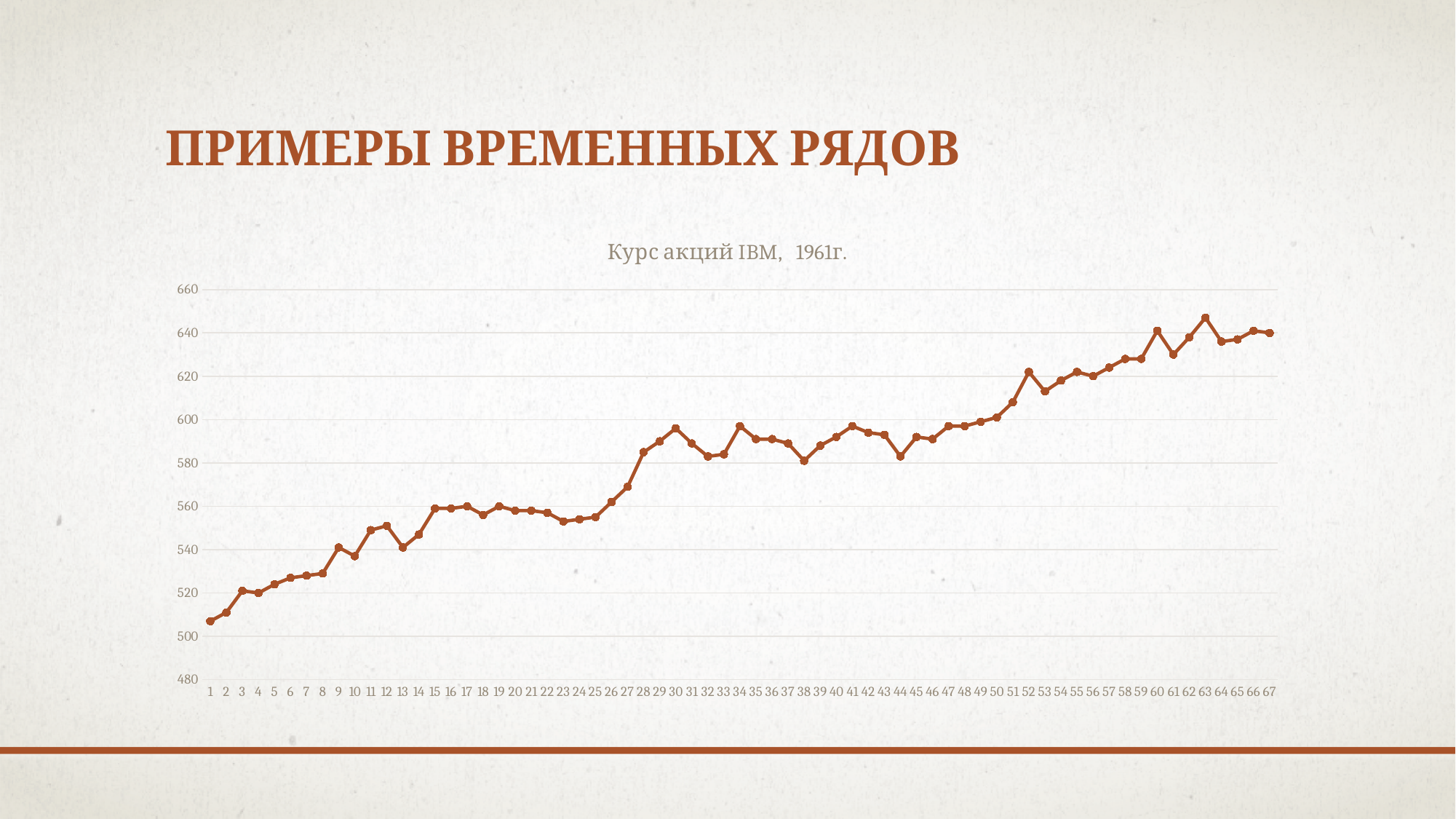
Is the value at point 63 greater or less than 640? greater Is the value at point 53 greater or less than 620? less Is the value at point 61 greater or less than 640? less What kind of chart is shown on the slide? line chart Which is larger, the value at point 30 or the value at point 44? point 30 At which point on the x axis is the value highest? 63 At which point on the x axis is the value lowest? 1 Do the values generally rise or fall from point 1 to point 67? rise What is the title of the chart? Курс акций IBM, 1961г. How many data points are plotted on the chart? 67